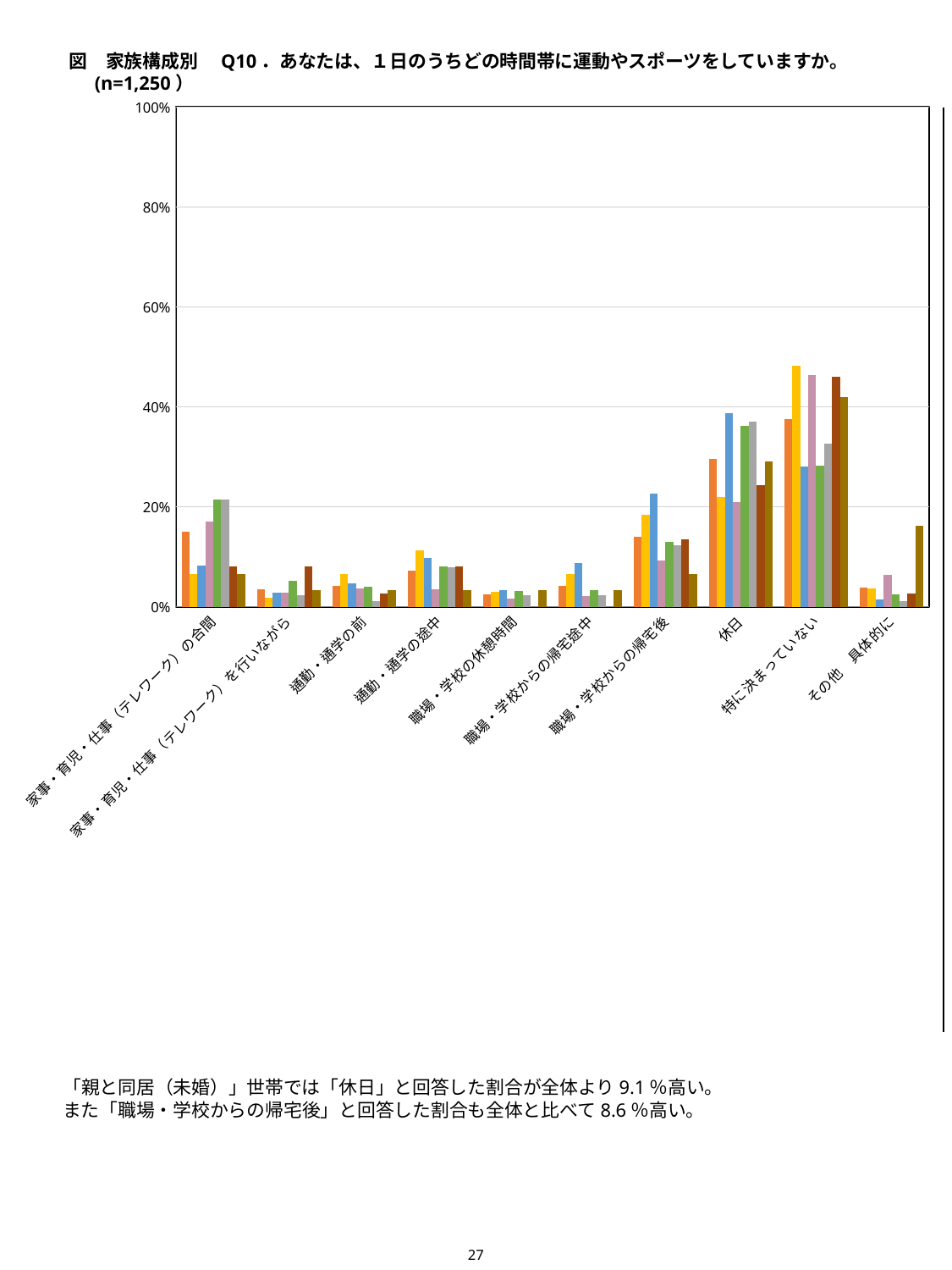
Is the tallest bar in the 特に決まっていない category greater or less than 40%? greater Is the tallest bar in the 通勤・通学の前 category greater or less than 20%? less Is the tallest bar in the 休日 category greater or less than 20%? greater Which category has taller bars overall: 特に決まっていない or その他 具体的に? 特に決まっていない Which category has taller bars overall: 休日 or 通勤・通学の途中? 休日 How many categories are shown along the x axis of the chart? 10 Which category contains the tallest bar in the chart? 特に決まっていない What is the maximum value shown on the chart's vertical axis? 100% What sample size (n) is stated in the chart title? n=1,250 What kind of chart is shown on the slide? bar chart